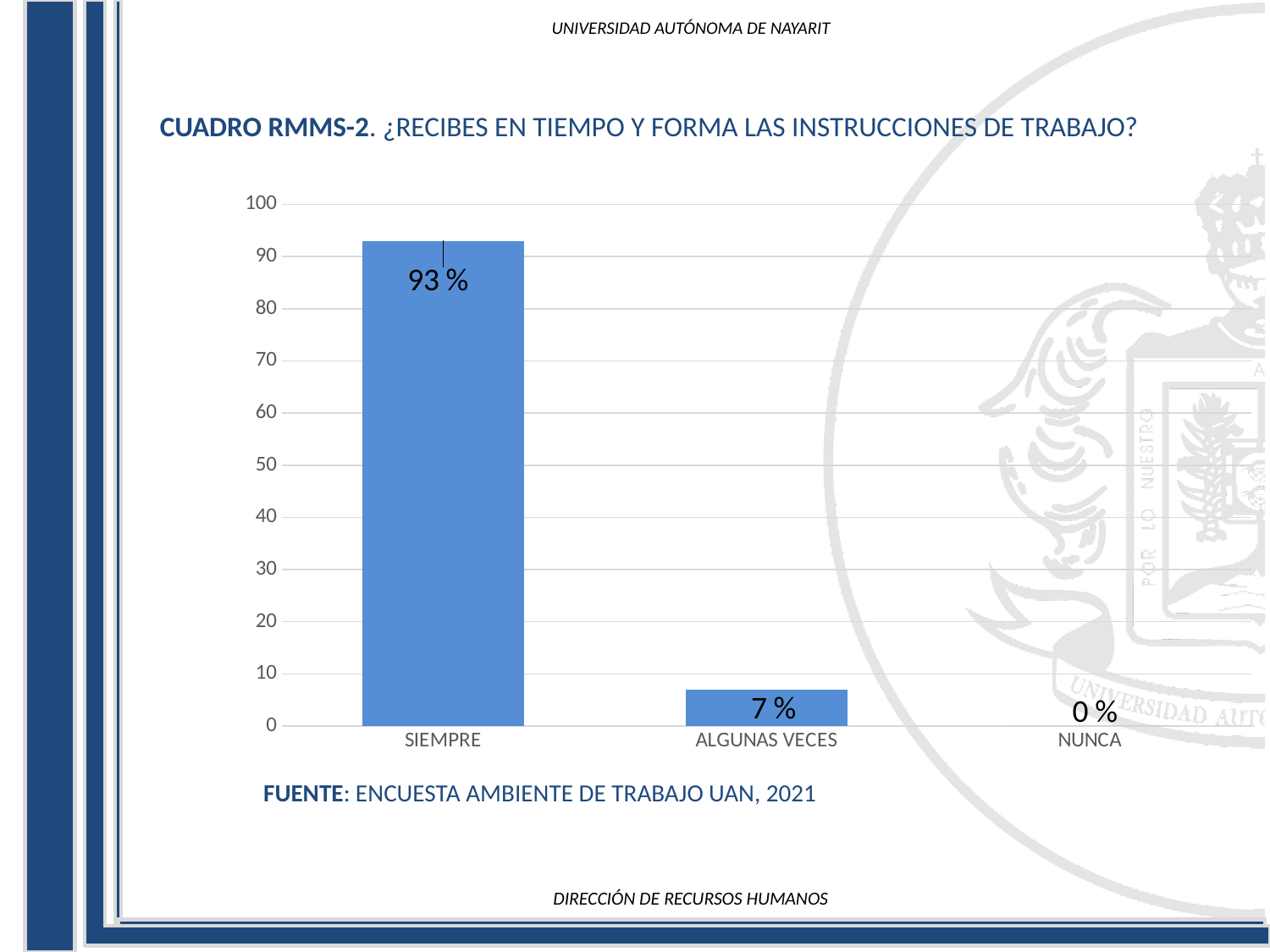
Is the value for SIEMPRE greater or less than 90? greater What kind of chart is shown on the slide? bar chart How many categories are shown on the x axis? 3 What is the value for SIEMPRE? 93 % Which category has the lowest value? NUNCA What is the value for NUNCA? 0 % Which is larger, the value for ALGUNAS VECES or the value for NUNCA? ALGUNAS VECES What is the difference between the values for SIEMPRE and ALGUNAS VECES? 86 % What is the source cited below the chart? ENCUESTA AMBIENTE DE TRABAJO UAN, 2021 Which category has the highest value? SIEMPRE What is the value for ALGUNAS VECES? 7 % Is the value for ALGUNAS VECES greater or less than 10? less